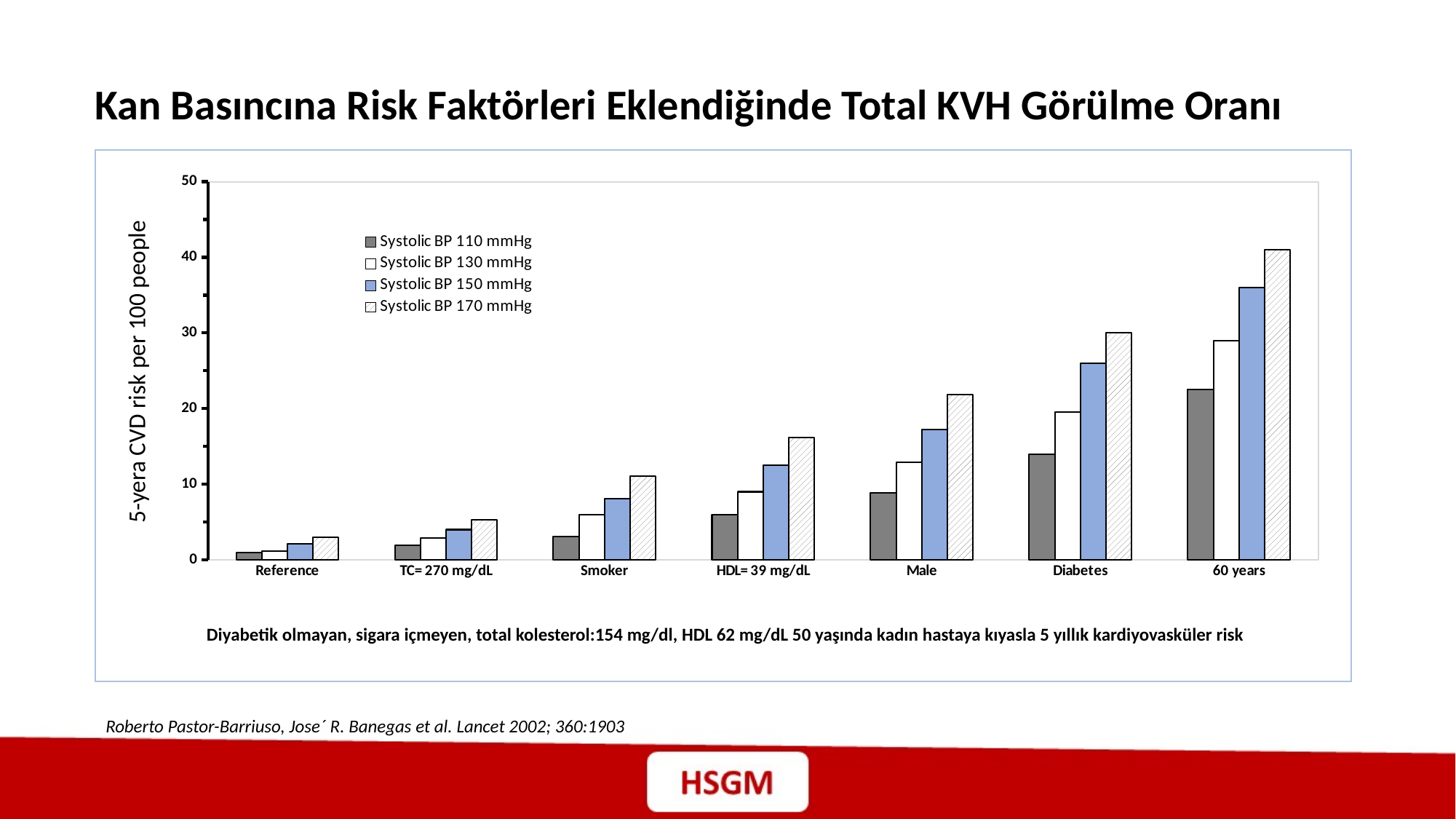
How many series does the legend list? 4 Which category has the lowest value for Systolic BP 110 mmHg? Reference What is the label of the y axis? 5-yera CVD risk per 100 people Do the Systolic BP 170 mmHg values rise or fall from Reference to 60 years along the x axis? rise What kind of chart is shown on the slide? bar chart Is the value for Reference at Systolic BP 170 mmHg greater or less than 10? less Is the value for Diabetes at Systolic BP 110 mmHg greater or less than 10? greater Which is larger for Systolic BP 170 mmHg: Diabetes or Male? Diabetes How many categories are shown on the x axis? 7 Is the value for Diabetes at Systolic BP 150 mmHg greater or less than 20? greater Which category has the highest value for Systolic BP 170 mmHg? 60 years